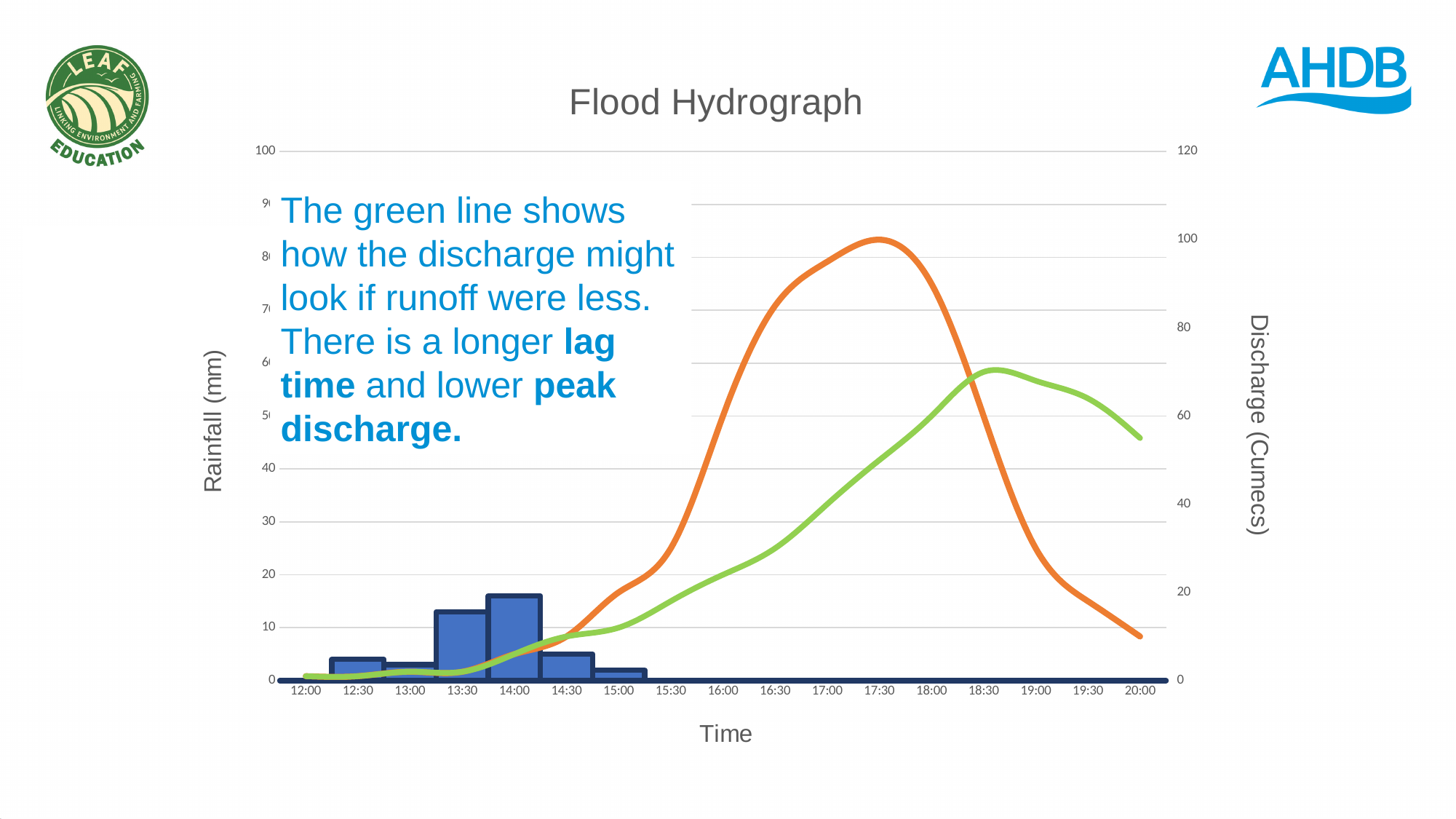
What kind of chart is used to show the rainfall data? bar chart Is the peak of the orange discharge line greater or less than 80 cumecs? greater At which time is the rainfall bar tallest? 14:00 Is the tallest rainfall bar greater or less than 20 mm? less At which time does the orange discharge line reach its peak? 17:30 What kind of chart is used to show the discharge data? line chart What is the title of the chart? Flood Hydrograph Which line has the higher peak discharge, the orange line or the green line? orange How many rainfall bars are plotted on the chart? 6 Which line reaches its peak later, the orange line or the green line? green Is the peak of the green discharge line greater or less than 80 cumecs? less What is the label of the right-hand vertical axis? Discharge (Cumecs)